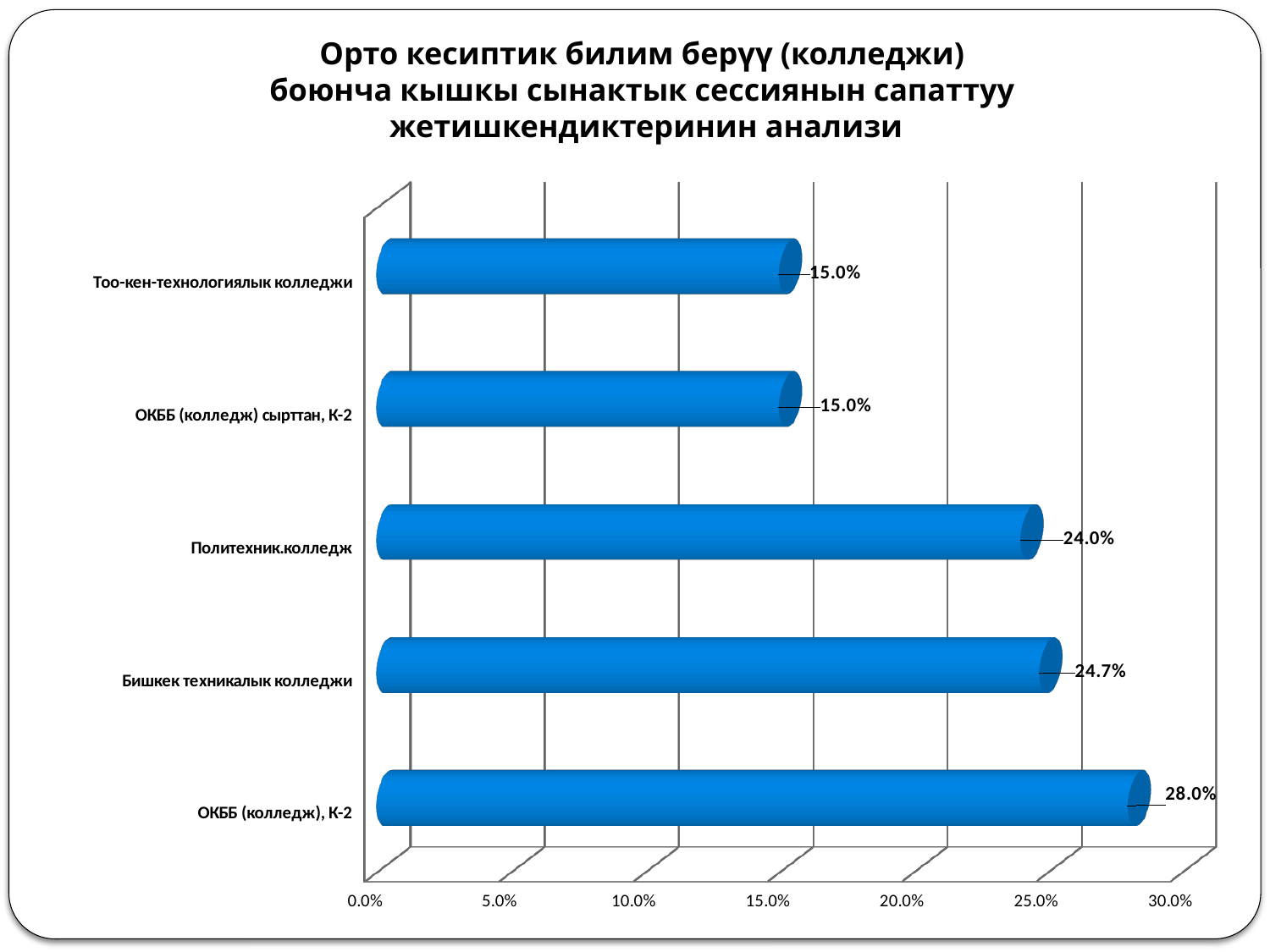
What is the value for Политехник.колледж? 24.0% Which category has the highest value? ОКББ (колледж), К-2 What is the maximum value shown on the horizontal axis? 30.0% What is the value for ОКББ (колледж), К-2? 28.0% Which is larger, the value for Бишкек техникалык колледжи or the value for Политехник.колледж? Бишкек техникалык колледжи What is the value for Тоо-кен-технологиялык колледжи? 15.0% What is the value for Бишкек техникалык колледжи? 24.7% What kind of chart is shown on the slide? bar chart Is the value for ОКББ (колледж), К-2 greater or less than 25.0%? greater What is the difference between the values for Политехник.колледж and ОКББ (колледж) сырттан, К-2? 9.0% What is the difference between the values for ОКББ (колледж), К-2 and Бишкек техникалык колледжи? 3.3% How many categories are shown in the chart? 5